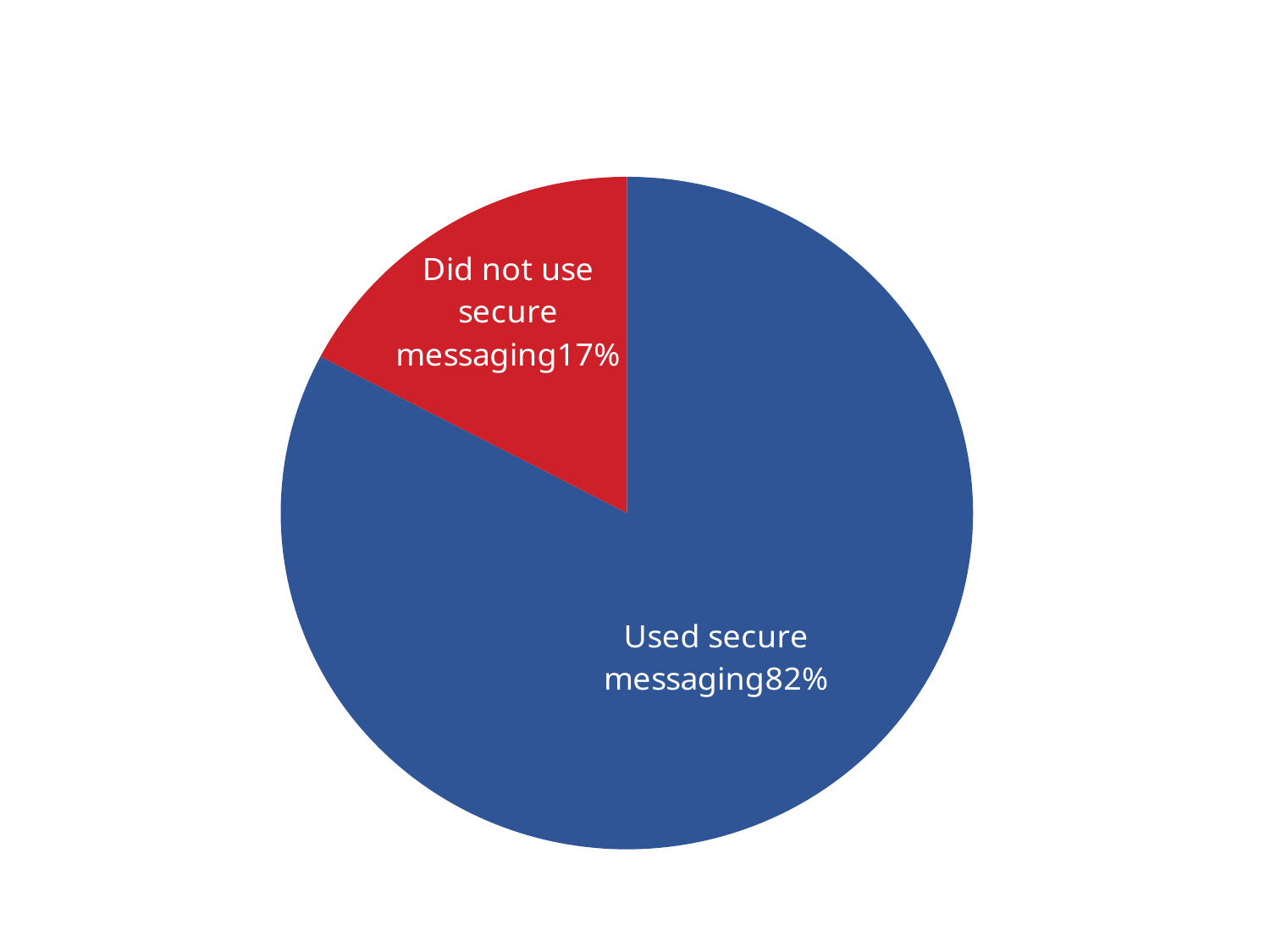
What colour is the "Did not use secure messaging" slice? red How many slices does the pie chart have? 2 Which slice of the pie is the smallest? Did not use secure messaging What colour is the "Used secure messaging" slice? blue What share of the pie is labelled "Used secure messaging"? 82% Which is larger: the "Used secure messaging" slice or the "Did not use secure messaging" slice? Used secure messaging Which slice of the pie is the largest? Used secure messaging What kind of chart is shown on the slide? pie chart What share of the pie is labelled "Did not use secure messaging"? 17% What is the difference in percentage points between the "Used secure messaging" slice and the "Did not use secure messaging" slice? 65